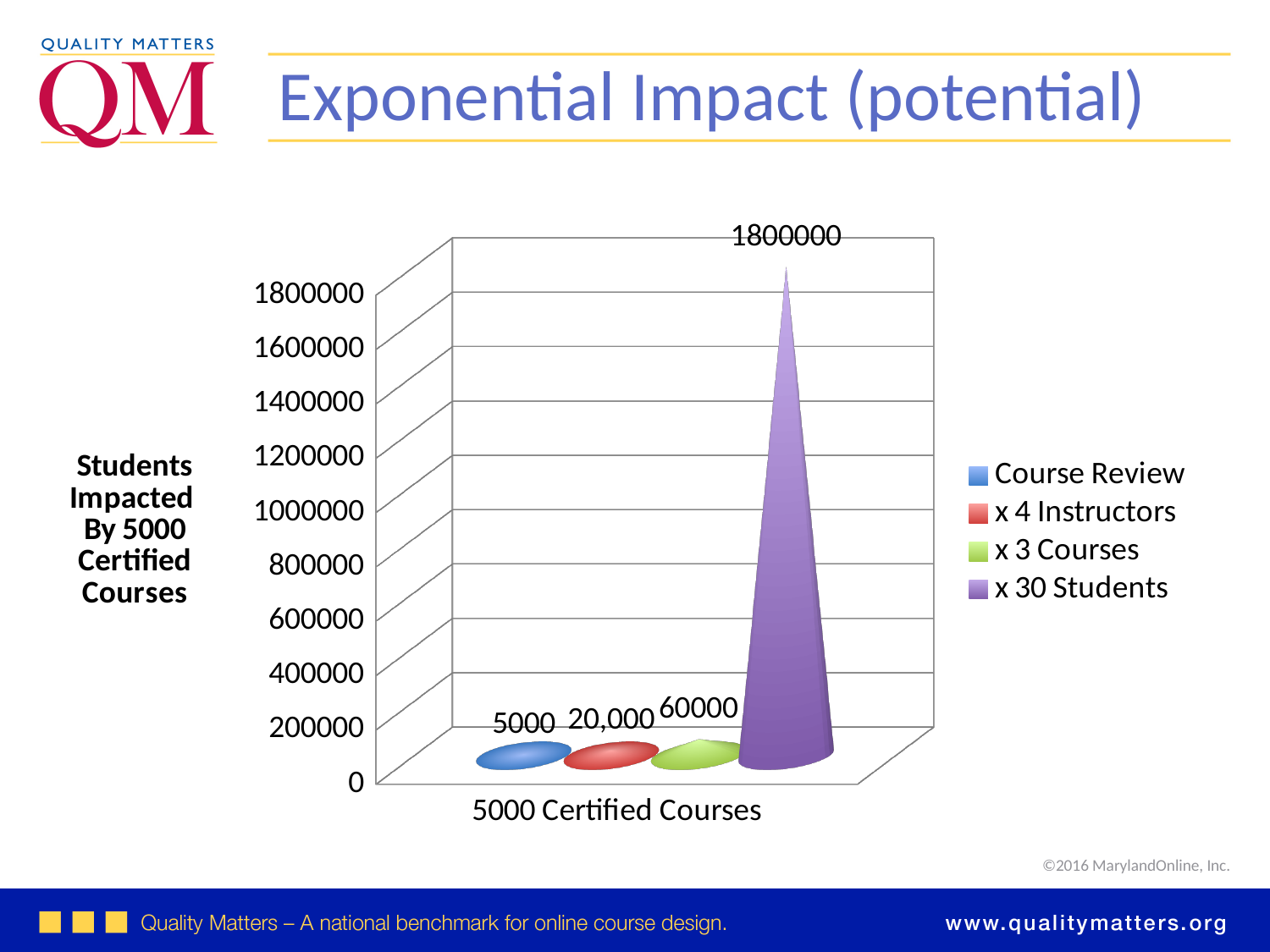
What is the label of the category on the x axis? 5000 Certified Courses What is the difference between the x 30 Students value and the x 3 Courses value? 1740000 How many series does the legend list? 4 Which is larger, the value for x 3 Courses or the value for x 4 Instructors? x 3 Courses What is the value for the x 30 Students series? 1800000 How many categories are shown on the x axis? 1 Which series has the lowest value? Course Review What is the value for the x 4 Instructors series? 20,000 What is the value for the x 3 Courses series? 60000 Is the value for x 30 Students greater or less than 1600000? greater Which series has the highest value? x 30 Students What is the value for the Course Review series? 5000